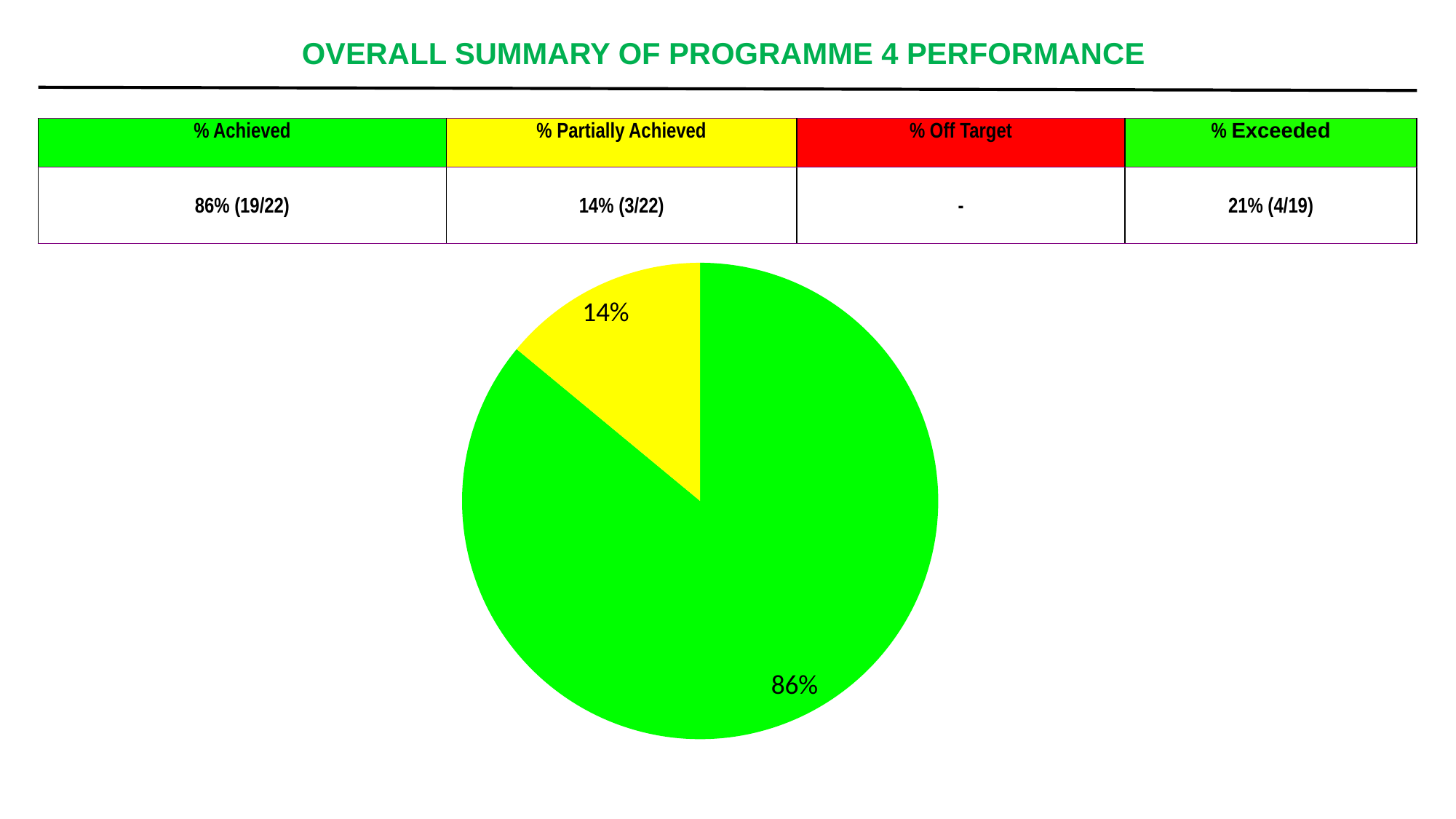
How many slices does the pie chart have? 2 Is the green slice or the yellow slice of the pie chart larger? the green slice What is the total of the two slice percentages shown on the pie chart? 100% What percentage is shown on the yellow slice of the pie chart? 14% What kind of chart is shown on the slide? pie chart Which slice of the pie chart is the smallest? the yellow slice (14%) Which slice of the pie chart is the largest? the green slice (86%) What colour is the slice labelled 86% in the pie chart? green What percentage is shown on the green slice of the pie chart? 86% What share of the pie does the yellow slice represent? 14% Does the pie chart include a legend? No What is the difference in percentage points between the green slice and the yellow slice of the pie chart? 72